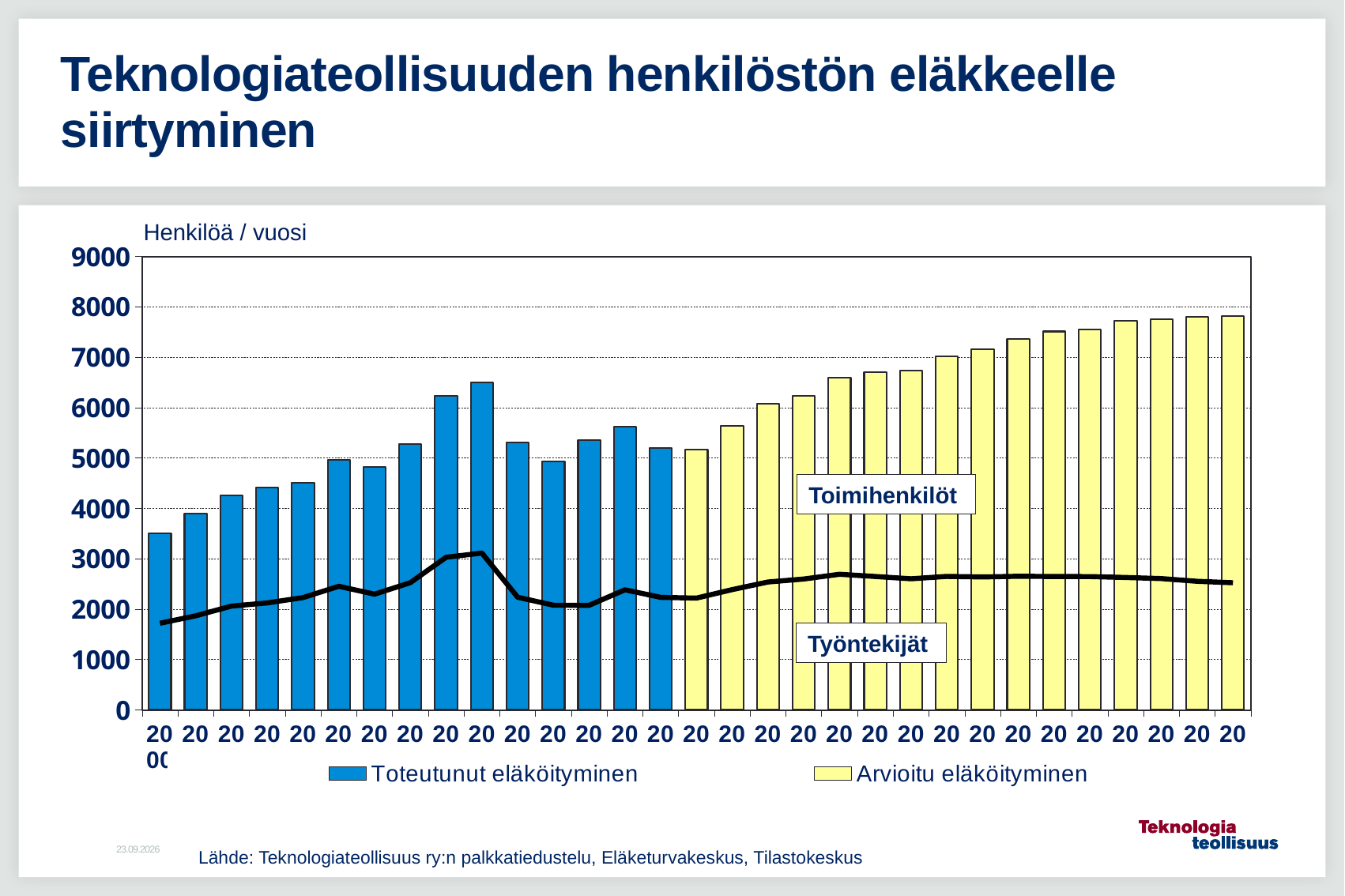
Is the tallest blue bar (Toteutunut eläköityminen) greater or less than 6000? greater How many blue Toteutunut eläköityminen bars are plotted? 15 Do the yellow Arvioitu eläköityminen bars generally rise or fall from left to right? rise How many series does the legend list? 2 Which series contains the tallest bar on the chart, Toteutunut eläköityminen or Arvioitu eläköityminen? Arvioitu eläköityminen Is the first (leftmost) blue bar greater or less than 4000? less What is the label shown above the vertical axis? Henkilöä / vuosi What kind of chart is shown on the slide? bar and line chart What are the two series named in the legend? Toteutunut eläköityminen and Arvioitu eläköityminen Is the last (rightmost) yellow bar greater or less than 7000? greater Which series is drawn with blue bars? Toteutunut eläköityminen